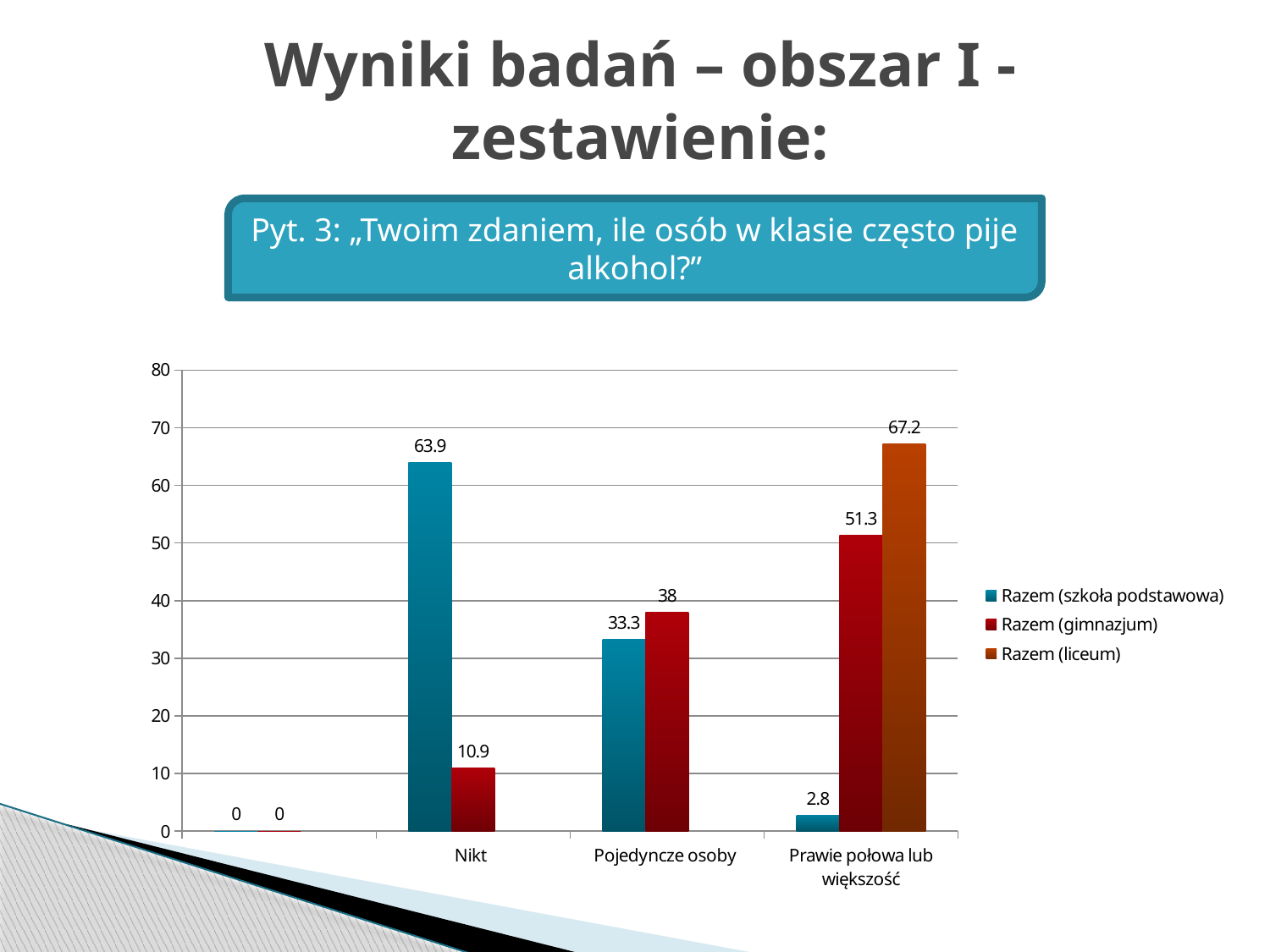
What is the value for Razem (szkoła podstawowa) in the Prawie połowa lub większość category? 2.8 What is the value for Razem (gimnazjum) in the Nikt category? 10.9 What kind of chart is shown on the slide? bar chart What is the difference between Razem (liceum) and Razem (gimnazjum) in the Prawie połowa lub większość category? 15.9 What is the value for Razem (liceum) in the Prawie połowa lub większość category? 67.2 In the Pojedyncze osoby category, which series has the larger value: Razem (szkoła podstawowa) or Razem (gimnazjum)? Razem (gimnazjum) What is the value for Razem (szkoła podstawowa) in the Nikt category? 63.9 How many series does the legend list? 3 What is the value for Razem (gimnazjum) in the Pojedyncze osoby category? 38 In which category is the Razem (gimnazjum) value highest? Prawie połowa lub większość What is the difference between Razem (szkoła podstawowa) and Razem (gimnazjum) in the Nikt category? 53 In which category is the Razem (szkoła podstawowa) value highest? Nikt